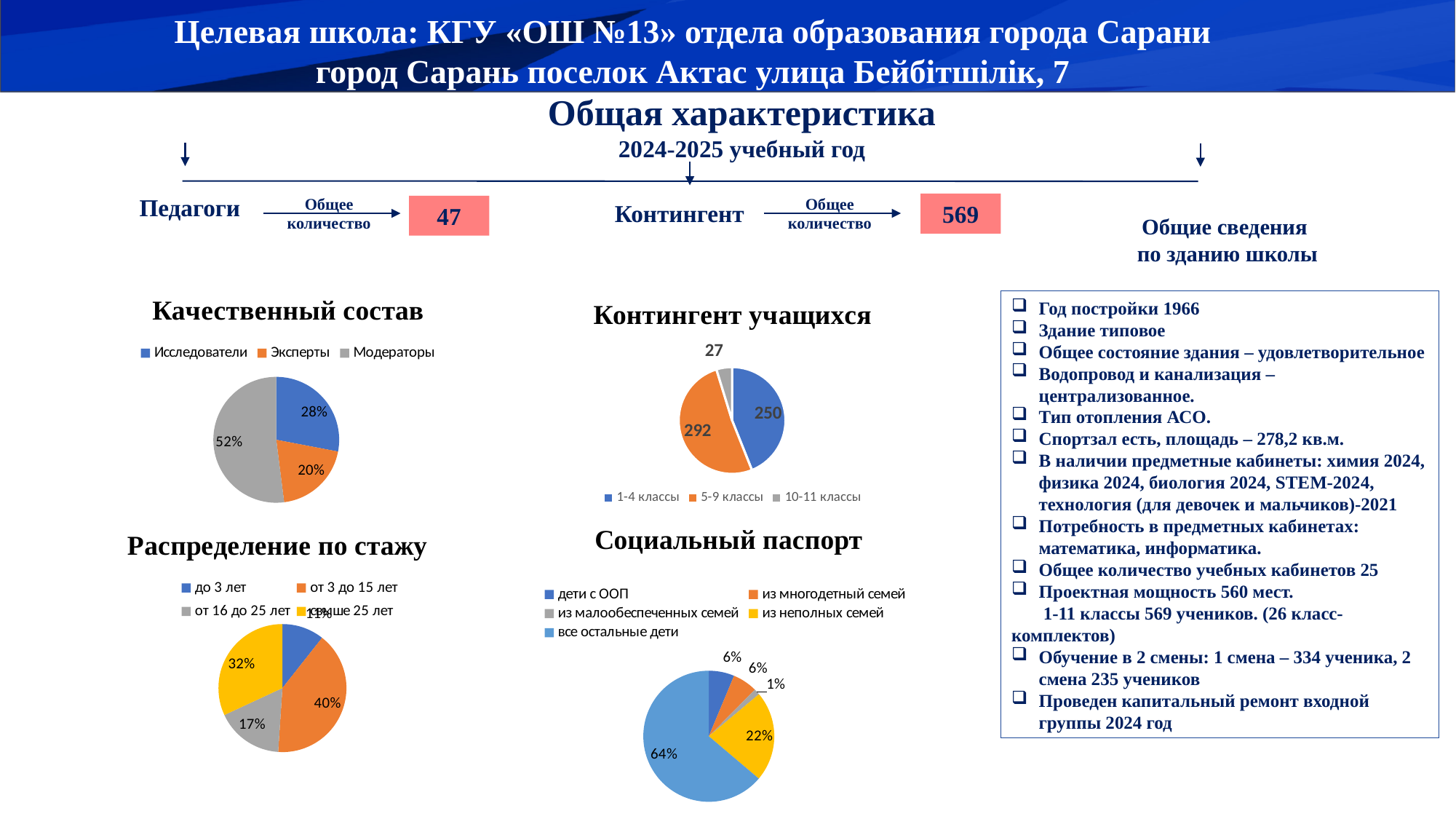
What type of chart is 'Социальный паспорт'? Pie chart In the 'Качественный состав' chart, what percentage is shown for Модераторы? 52% In the 'Качественный состав' chart, what is the difference in percentage points between Исследователи and Эксперты? 8 In the 'Распределение по стажу' chart, what percentage is shown for от 3 до 15 лет? 40% In the 'Контингент учащихся' chart, what value is shown for 5-9 классы? 292 In the 'Контингент учащихся' chart, how many categories does the legend list? 3 In the 'Социальный паспорт' chart, what percentage is shown for из неполных семей? 22% In the 'Социальный паспорт' chart, what percentage is shown for все остальные дети? 64% In the 'Контингент учащихся' chart, what is the total of the three values shown? 569 In the 'Контингент учащихся' chart, which category has the largest value? 5-9 классы In the 'Распределение по стажу' chart, which is larger: от 16 до 25 лет or свыше 25 лет? свыше 25 лет In the 'Качественный состав' chart, which category has the smallest share? Эксперты